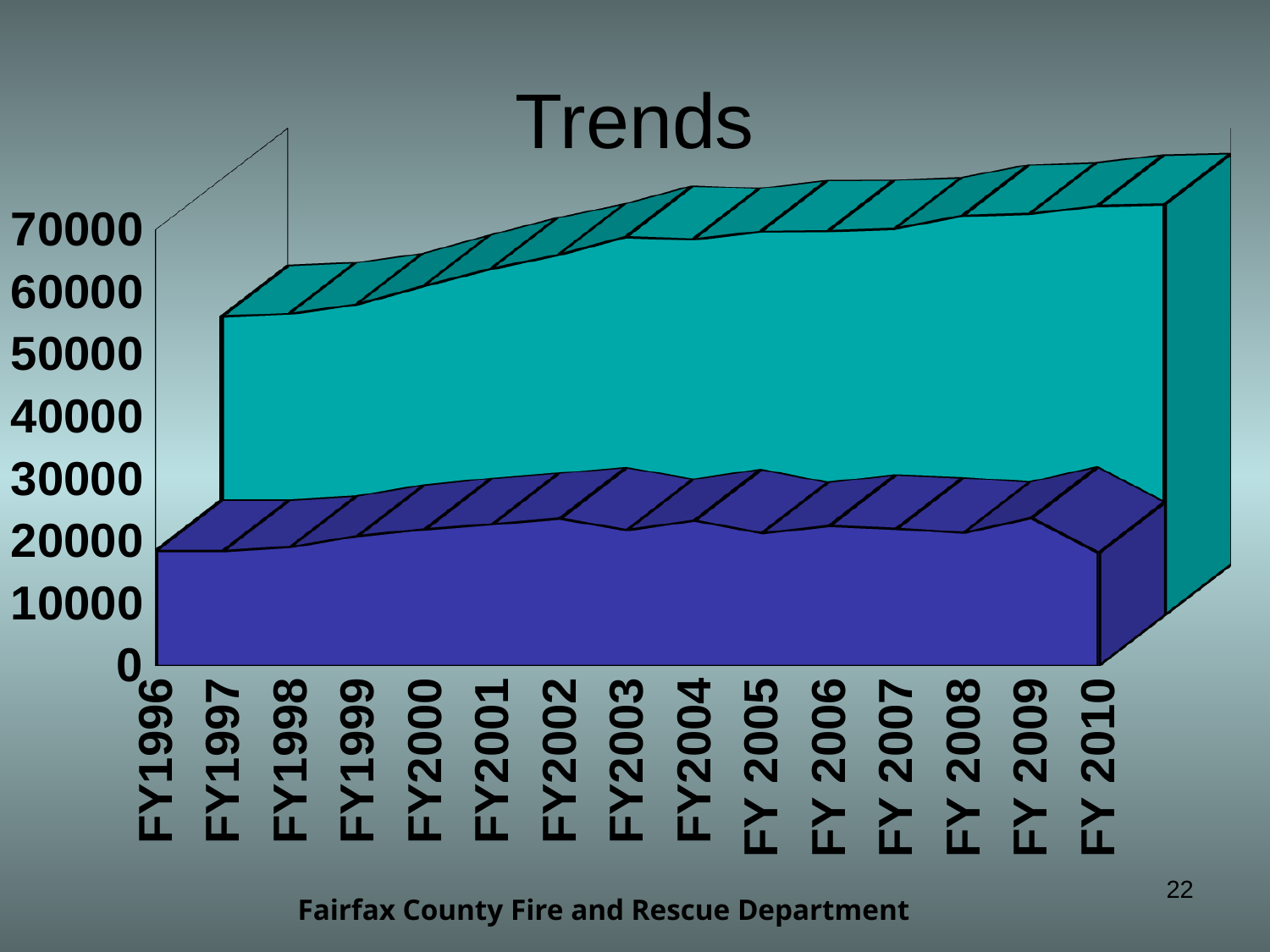
Is the value of the upper (teal) series for FY 2010 greater or less than 60000? greater What is the first fiscal year shown on the x axis? FY1996 Which series has the larger value in FY2003, the teal series or the purple series? the teal series What is the title of the chart? Trends Is the value of the lower (purple) series for FY1996 greater or less than 30000? less How many fiscal years are shown along the x axis? 15 What is the highest value labelled on the y axis? 70000 Is the value of the lower (purple) series for FY 2010 greater or less than 30000? less What kind of chart is shown on the slide? area chart Does the upper (teal) series rise or fall from FY1996 to FY 2010? rise